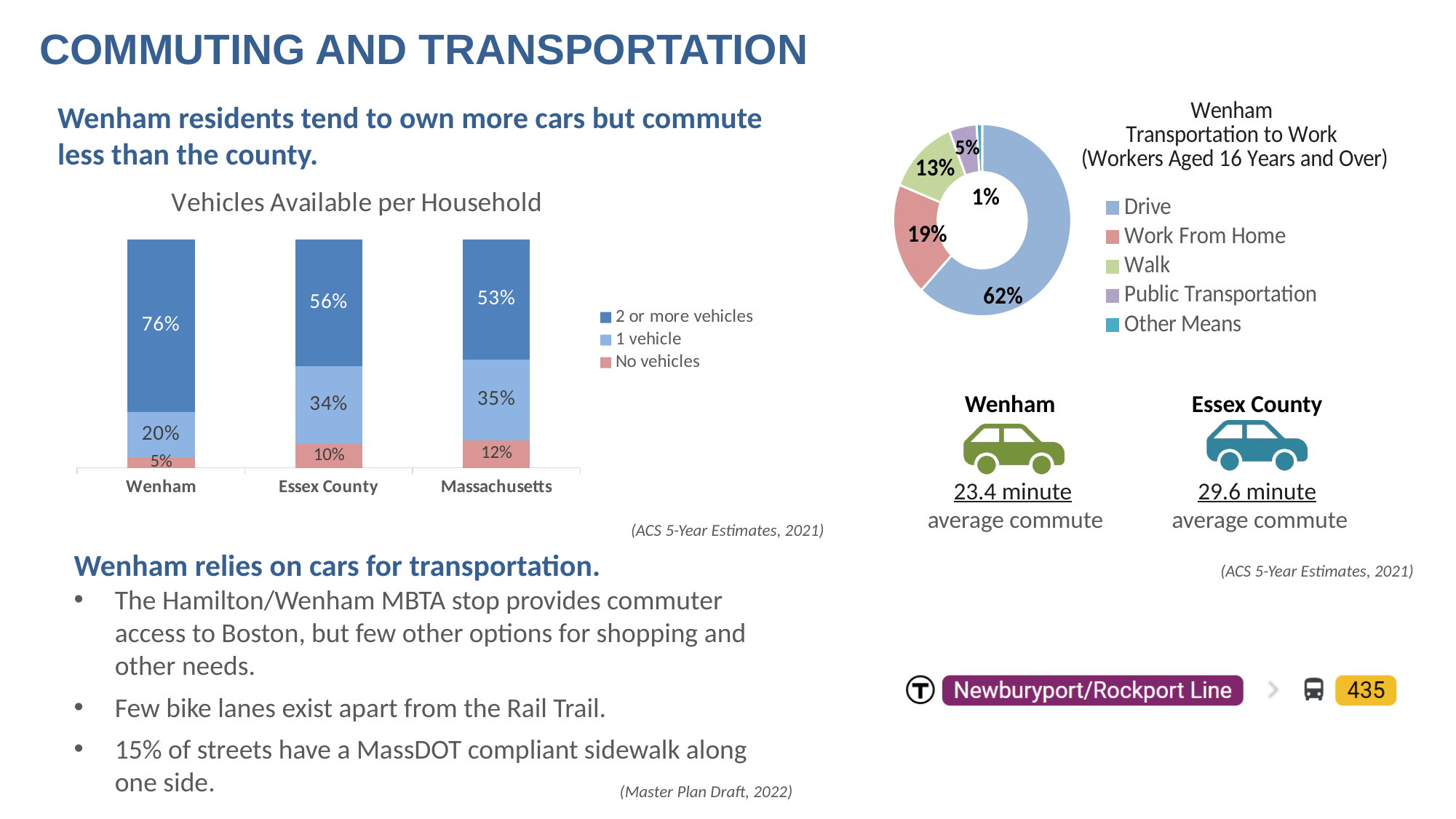
What kind of chart is 'Vehicles Available per Household'? Stacked bar chart In the 'Vehicles Available per Household' chart, what is the difference between the '1 vehicle' share for Essex County and for Wenham? 14% In the 'Wenham Transportation to Work' chart, what share of workers drive? 62% How many categories does the 'Wenham Transportation to Work' chart show? 5 In the 'Vehicles Available per Household' chart, what percentage of Massachusetts households have no vehicles? 12% How many series does the legend of the 'Vehicles Available per Household' chart list? 3 In the 'Wenham Transportation to Work' chart, which category has the smallest share? Other Means In the 'Wenham Transportation to Work' chart, what is the difference between the Work From Home share and the Public Transportation share? 14% In the 'Vehicles Available per Household' chart, what percentage of Wenham households have 2 or more vehicles? 76% In the 'Wenham Transportation to Work' chart, what percentage of workers walk? 13% In the 'Vehicles Available per Household' chart, which has a larger '2 or more vehicles' share, Essex County or Massachusetts? Essex County In the 'Vehicles Available per Household' chart, which category has the lowest share of households with no vehicles? Wenham